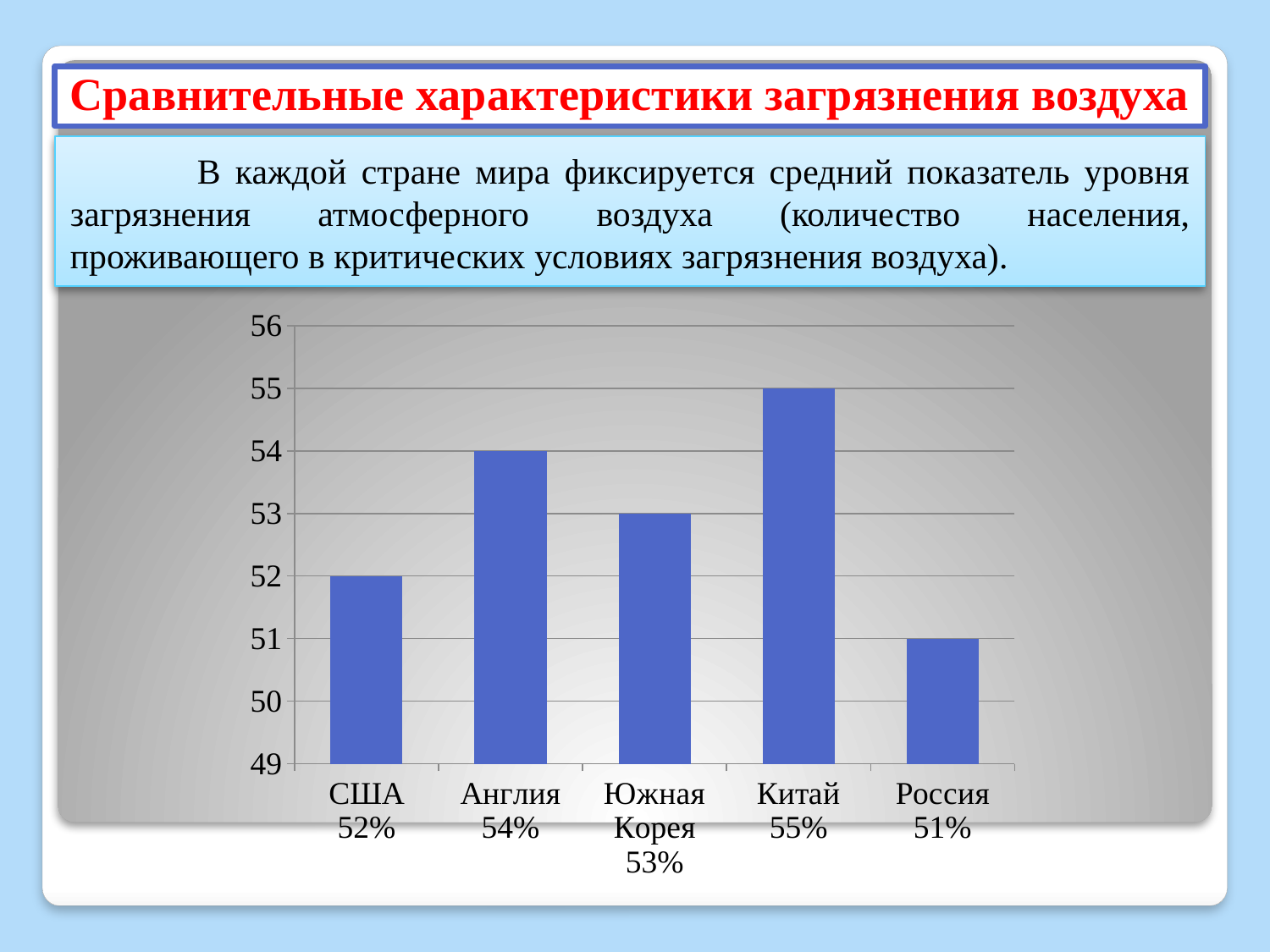
What kind of chart is shown on the slide? bar chart Which country has the highest value? Китай What is the value for Россия? 51% What is the value for Южная Корея? 53% What is the difference between the values for Китай and Россия? 4% How many countries are shown in the chart? 5 Which country has the lowest value? Россия What is the title of the slide? Сравнительные характеристики загрязнения воздуха Is the value for США greater or less than 53? less What is the value for Китай? 55% Which is larger, the value for Англия or the value for Южная Корея? Англия What is the difference between the values for Англия and США? 2%